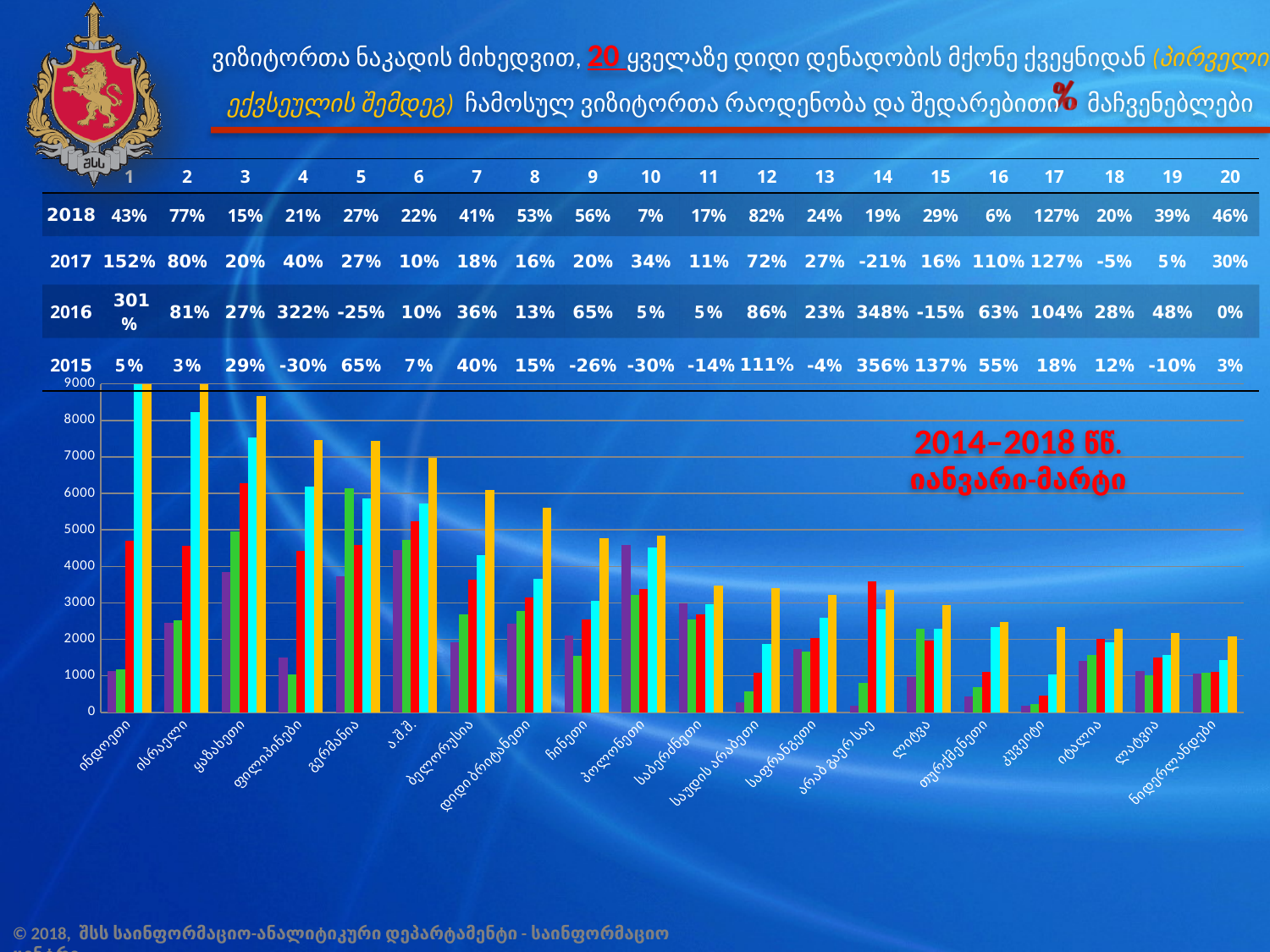
Is the yellow bar for ნიდერლანდები greater or less than 3000? less What is the highest value shown on the y axis of the bar chart? 9000 How many countries (categories) are shown on the x axis of the bar chart? 20 Is the yellow bar for ისრაელი greater or less than 8000? greater What kind of chart is shown on the slide? bar chart For ინდოეთი, which is larger: the purple bar or the yellow bar? the yellow bar Is the red bar for ყაზახეთი greater or less than 5000? greater Which is larger: the yellow bar for ინდოეთი or the yellow bar for ლიტვა? ინდოეთი What period label is printed in red inside the chart area? 2014-2018 წწ. იანვარი-მარტი How many bars are plotted for each country in the bar chart? 5 Do the yellow bars generally rise or fall from left to right across the countries? fall